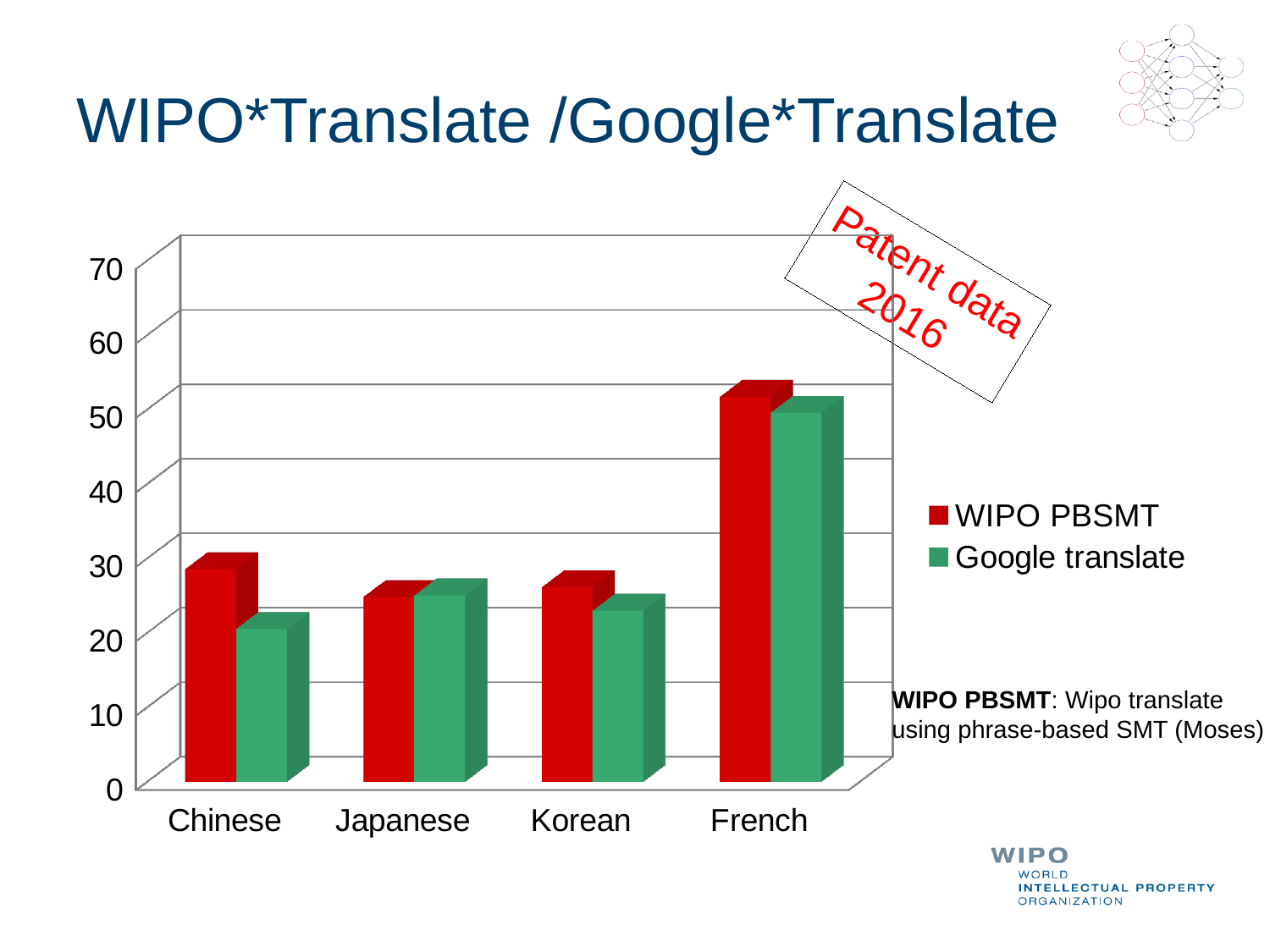
Which is larger: the WIPO PBSMT value for French or the WIPO PBSMT value for Chinese? French Is the WIPO PBSMT value for French greater or less than 40? greater Is the WIPO PBSMT value for Korean greater or less than 40? less Which language has the lowest Google translate value? Chinese Which language has the highest WIPO PBSMT value? French How many series does the legend list? 2 Which colour represents the Google translate series in the legend? green For Chinese, which is larger: the WIPO PBSMT value or the Google translate value? WIPO PBSMT Which language has the highest Google translate value? French Is the Google translate value for Chinese greater or less than 30? less What kind of chart is shown on the slide? bar chart How many language categories are shown on the x axis? 4